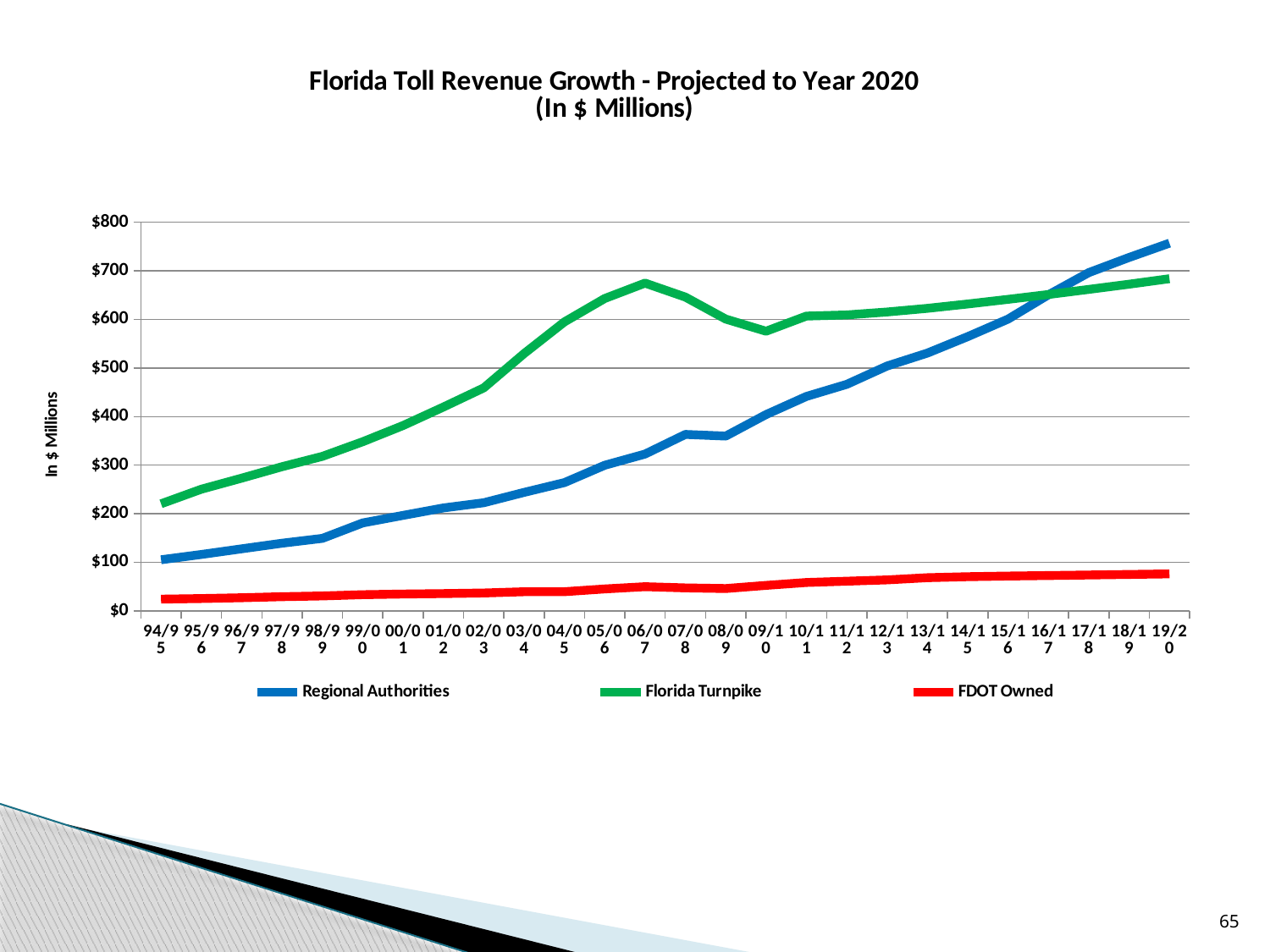
What is the title of the chart? Florida Toll Revenue Growth - Projected to Year 2020 (In $ Millions) Is the value for FDOT Owned in 19/20 greater or less than $100? less How many fiscal-year points are plotted along the x axis? 26 Which series has the lowest values across the whole period? FDOT Owned In 94/95, which is higher: Florida Turnpike or Regional Authorities? Florida Turnpike Is the value for Florida Turnpike in 06/07 greater or less than $600? greater Is the value for Regional Authorities in 94/95 greater or less than $200? less Do the Regional Authorities values generally rise or fall from 94/95 to 19/20? Rise How many series does the legend list? 3 In 19/20, which is higher: Regional Authorities or Florida Turnpike? Regional Authorities What kind of chart is shown on the slide? Line chart